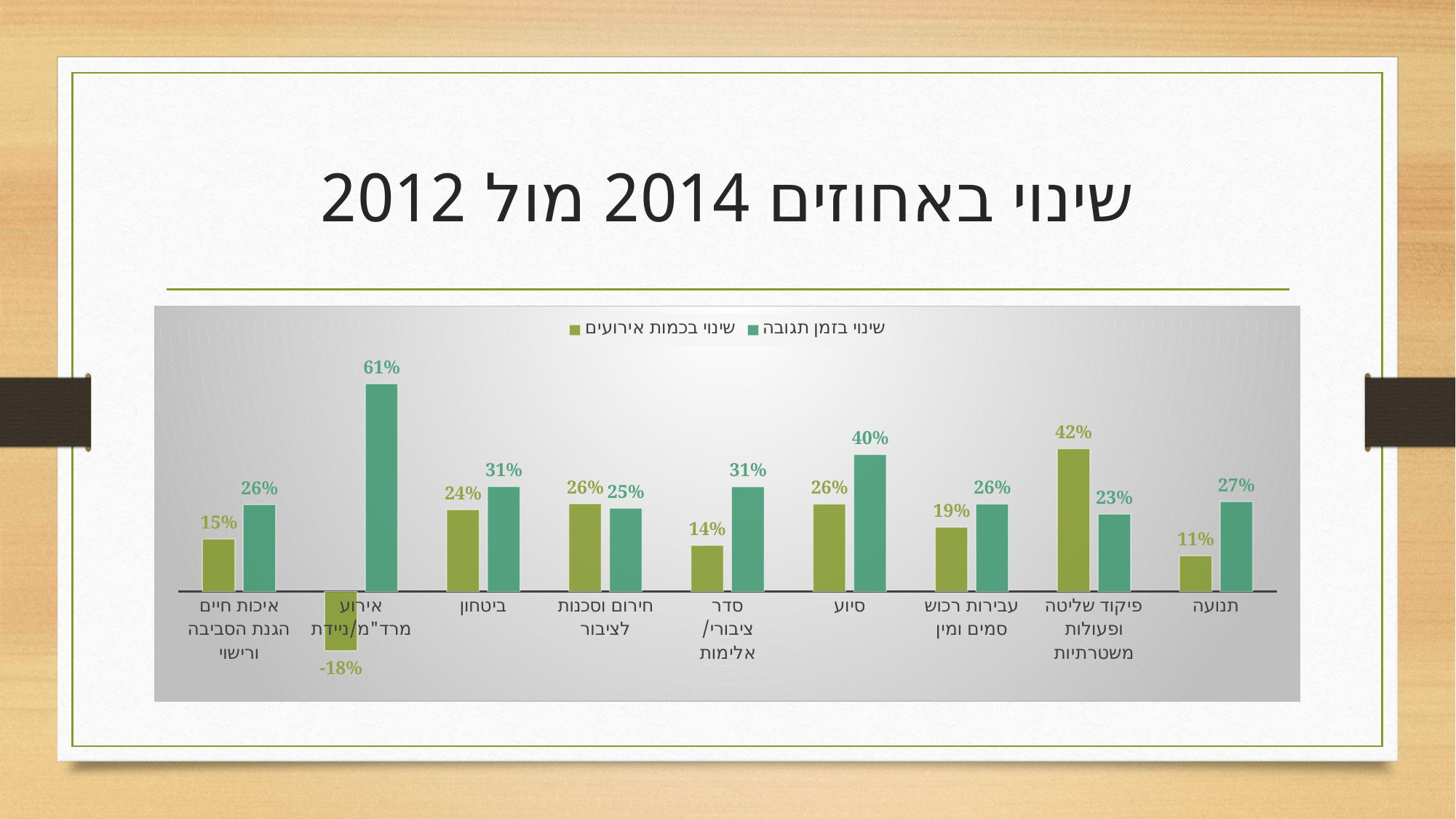
Which category has the highest value for שינוי בכמות אירועים? פיקוד שליטה ופעולות משטרתיות How many series does the legend list? 2 What is the value of שינוי בזמן תגובה for אירוע מרד"מ/ניידת? 61% Which category has the highest value for שינוי בזמן תגובה? אירוע מרד"מ/ניידת How many categories are shown on the x axis? 9 For פיקוד שליטה ופעולות משטרתיות, which is larger: שינוי בכמות אירועים or שינוי בזמן תגובה? שינוי בכמות אירועים What is the value of שינוי בכמות אירועים for ביטחון? 24% What is the value of שינוי בכמות אירועים for תנועה? 11% Which category has the lowest value for שינוי בכמות אירועים? אירוע מרד"מ/ניידת What is the difference between שינוי בזמן תגובה and שינוי בכמות אירועים for סיוע? 14% What is the title of the slide? שינוי באחוזים 2014 מול 2012 What kind of chart is shown on the slide? Bar chart